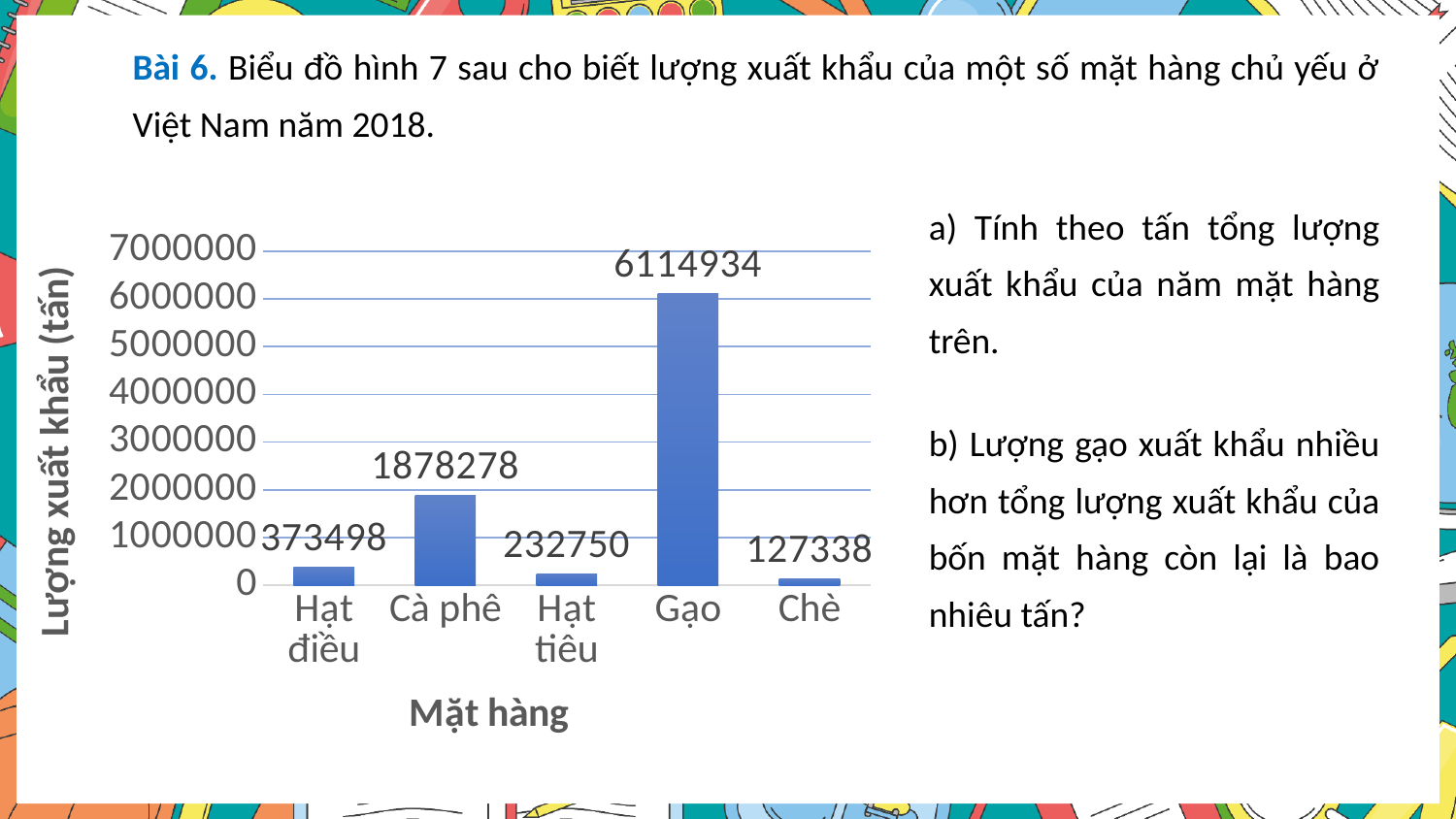
What is the export volume for Gạo? 6114934 What is the export volume for Cà phê? 1878278 How many products are shown on the chart? 5 What is the difference between the export volumes of Gạo and Cà phê? 4236656 What is the label of the vertical axis? Lượng xuất khẩu (tấn) Which product has the highest export volume? Gạo Which has a larger export volume, Hạt tiêu or Chè? Hạt tiêu What is the export volume for Chè? 127338 Which product has the lowest export volume? Chè What is the export volume for Hạt điều? 373498 What kind of chart is shown on the slide? Bar chart What is the difference between the export volumes of Hạt điều and Hạt tiêu? 140748